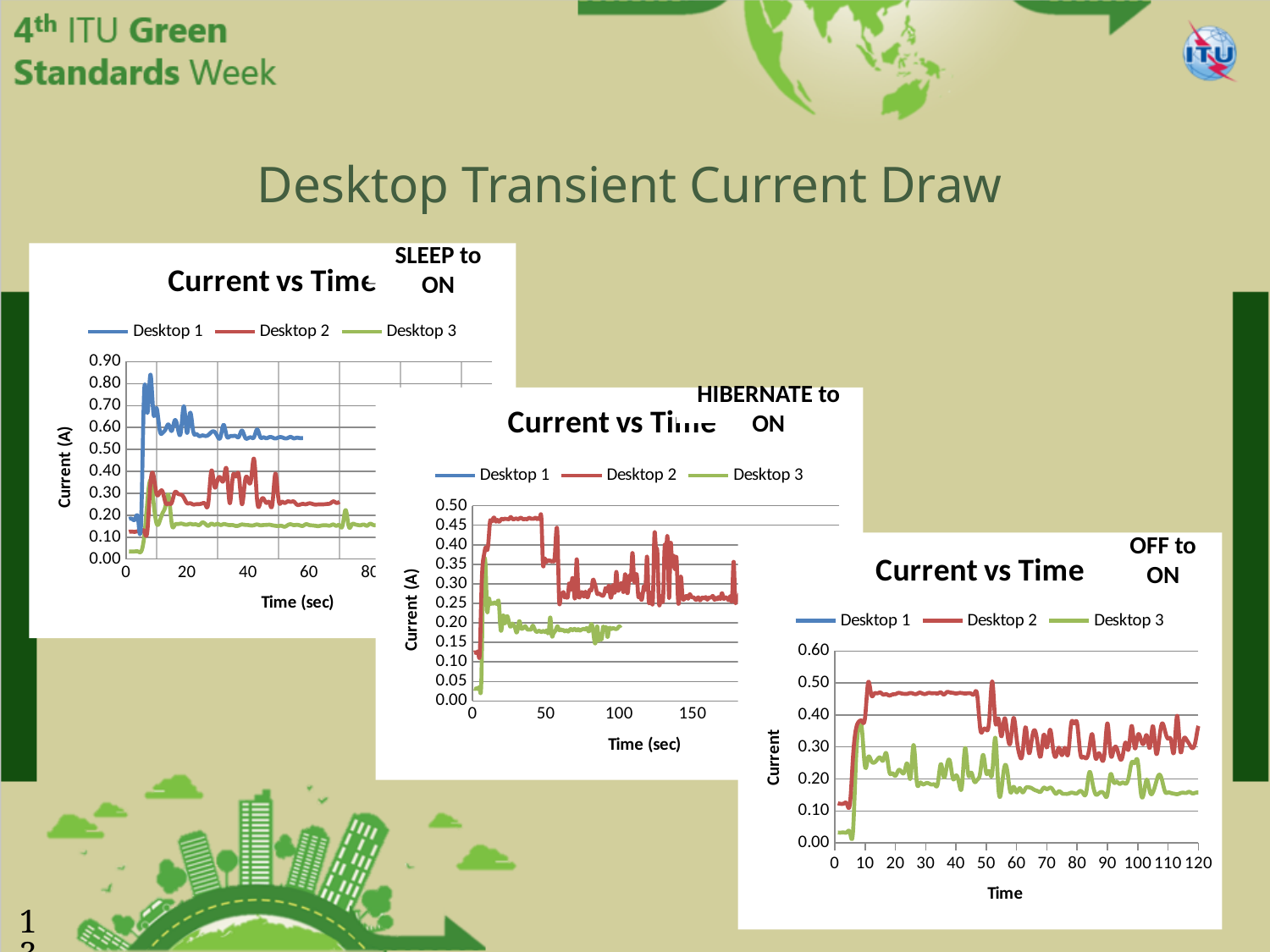
What is the x-axis title of the HIBERNATE to ON chart? Time (sec) In the OFF to ON chart, which has the higher current at 20 seconds, Desktop 2 or Desktop 3? Desktop 2 In the HIBERNATE to ON chart, is the value for Desktop 2 at 25 seconds greater or less than 0.40? greater In the SLEEP to ON chart, which desktop reaches the highest current? Desktop 1 How many series does the legend of the HIBERNATE to ON chart list? 3 In the SLEEP to ON chart, is the value for Desktop 1 at 40 seconds greater or less than 0.50? greater What kind of chart is the SLEEP to ON "Current vs Time" chart? line chart In the SLEEP to ON chart, is the steady value for Desktop 3 after 20 seconds greater or less than 0.20? less How many charts are shown on the slide? 3